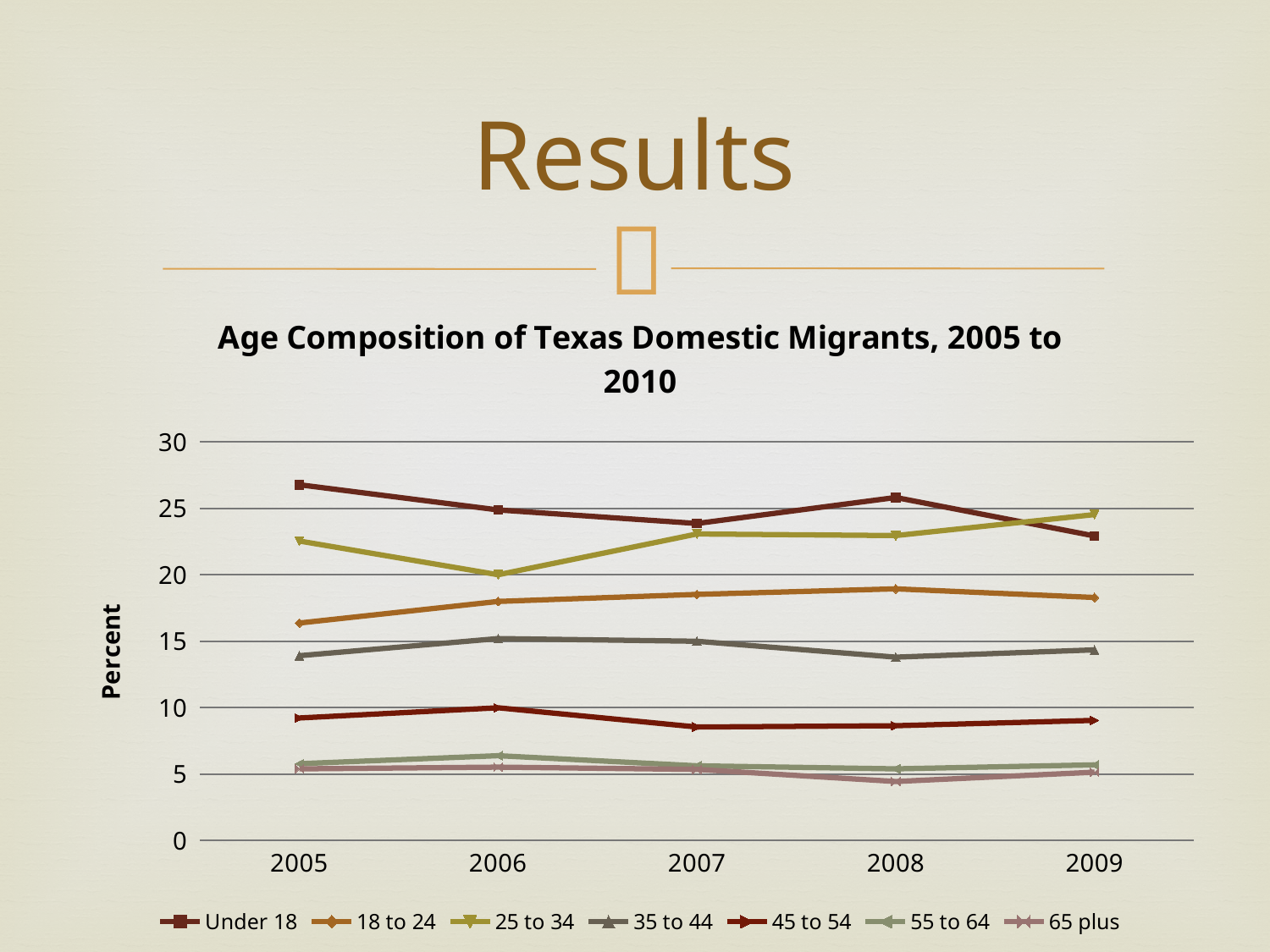
Is the value for Under 18 in 2005 greater or less than 25? greater In 2009, which is larger: Under 18 or 25 to 34? 25 to 34 What kind of chart is shown on the slide? line chart Is the value for 45 to 54 in 2007 greater or less than 10? less How many years are shown on the x axis? 5 What is the title of the chart? Age Composition of Texas Domestic Migrants, 2005 to 2010 What is the label on the y axis? Percent Does the 18 to 24 line rise or fall from 2005 to 2008? rise Which age group has the lowest value in 2008? 65 plus How many series does the legend list? 7 Which age group has the highest value in 2005? Under 18 Is the value for 18 to 24 in 2005 greater or less than 20? less